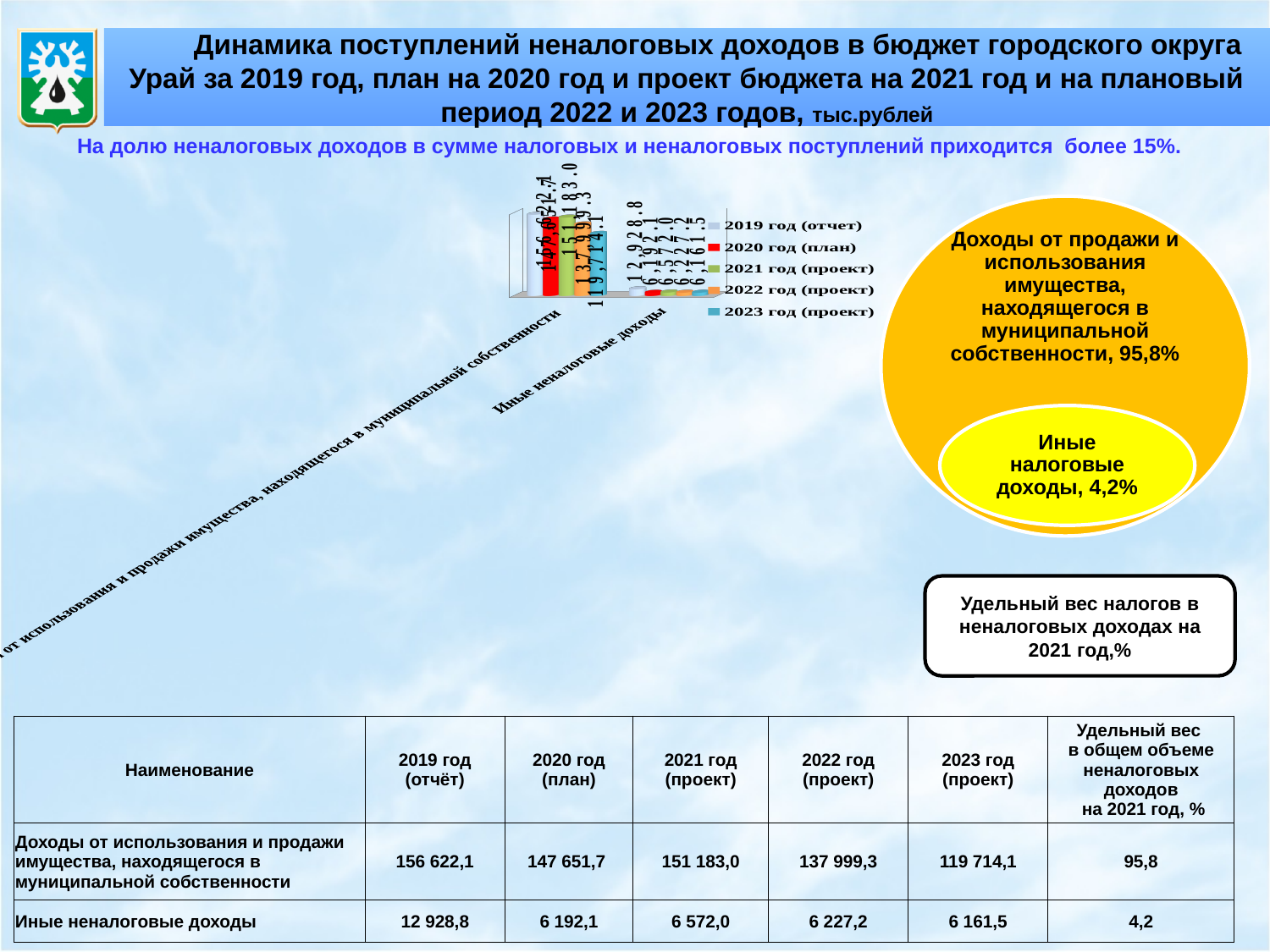
What is the difference between the 2019 год (отчет) and 2023 год (проект) values for 'Доходы от использования и продажи имущества, находящегося в муниципальной собственности'? 36 908,0 How many series does the legend of the bar chart list? 5 What is the value for 'Иные неналоговые доходы' in 2021 год (проект)? 6 572,0 How many categories are plotted on the bar chart? 2 What is the value for 'Иные неналоговые доходы' in 2023 год (проект)? 6 161,5 What is the value for 'Доходы от использования и продажи имущества, находящегося в муниципальной собственности' in 2019 год (отчет)? 156 622,1 Which year has the highest value for 'Доходы от использования и продажи имущества, находящегося в муниципальной собственности'? 2019 год (отчет) What kind of chart is shown on the slide? bar chart Which year has the lowest value for 'Иные неналоговые доходы'? 2023 год (проект) What is the first entry in the legend of the bar chart? 2019 год (отчет) What is the difference between the 2019 год (отчет) and 2020 год (план) values for 'Иные неналоговые доходы'? 6 736,7 For 'Доходы от использования и продажи имущества, находящегося в муниципальной собственности', which is larger: 2020 год (план) or 2021 год (проект)? 2021 год (проект)